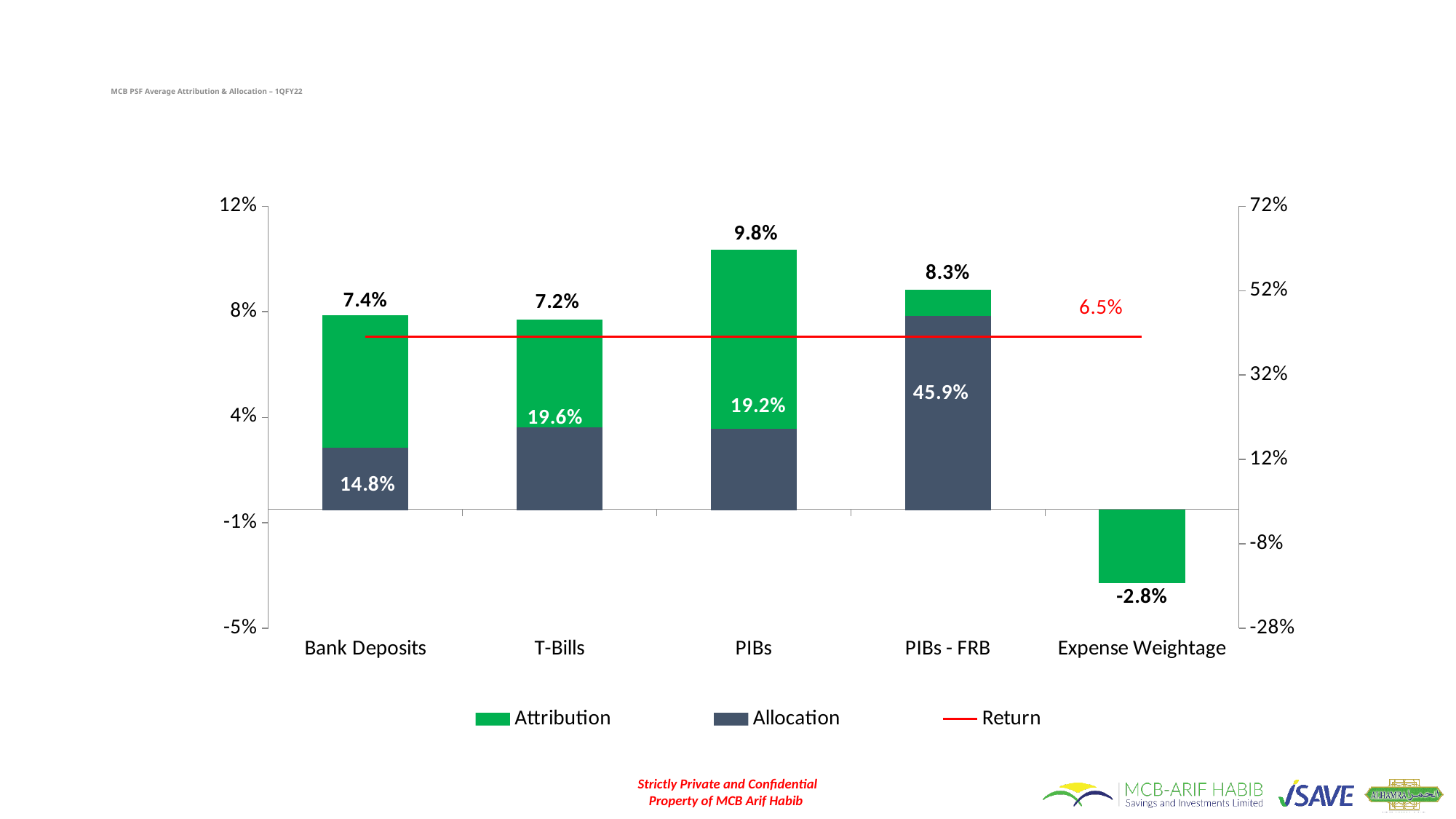
How many categories are shown on the x axis? 5 Which is larger, the Allocation for T-Bills or the Allocation for PIBs? T-Bills Which category has the lowest Attribution value? Expense Weightage What is the Attribution value for PIBs? 9.8% What is the difference between the Attribution values for PIBs and PIBs - FRB? 1.5% How many series does the legend list? 3 What is the Allocation value for Bank Deposits? 14.8% What is the Allocation value for PIBs - FRB? 45.9% What value is labelled on the Return line? 6.5% Which category has the highest Allocation value? PIBs - FRB What is the Attribution value for Expense Weightage? -2.8% Which category has the highest Attribution value? PIBs